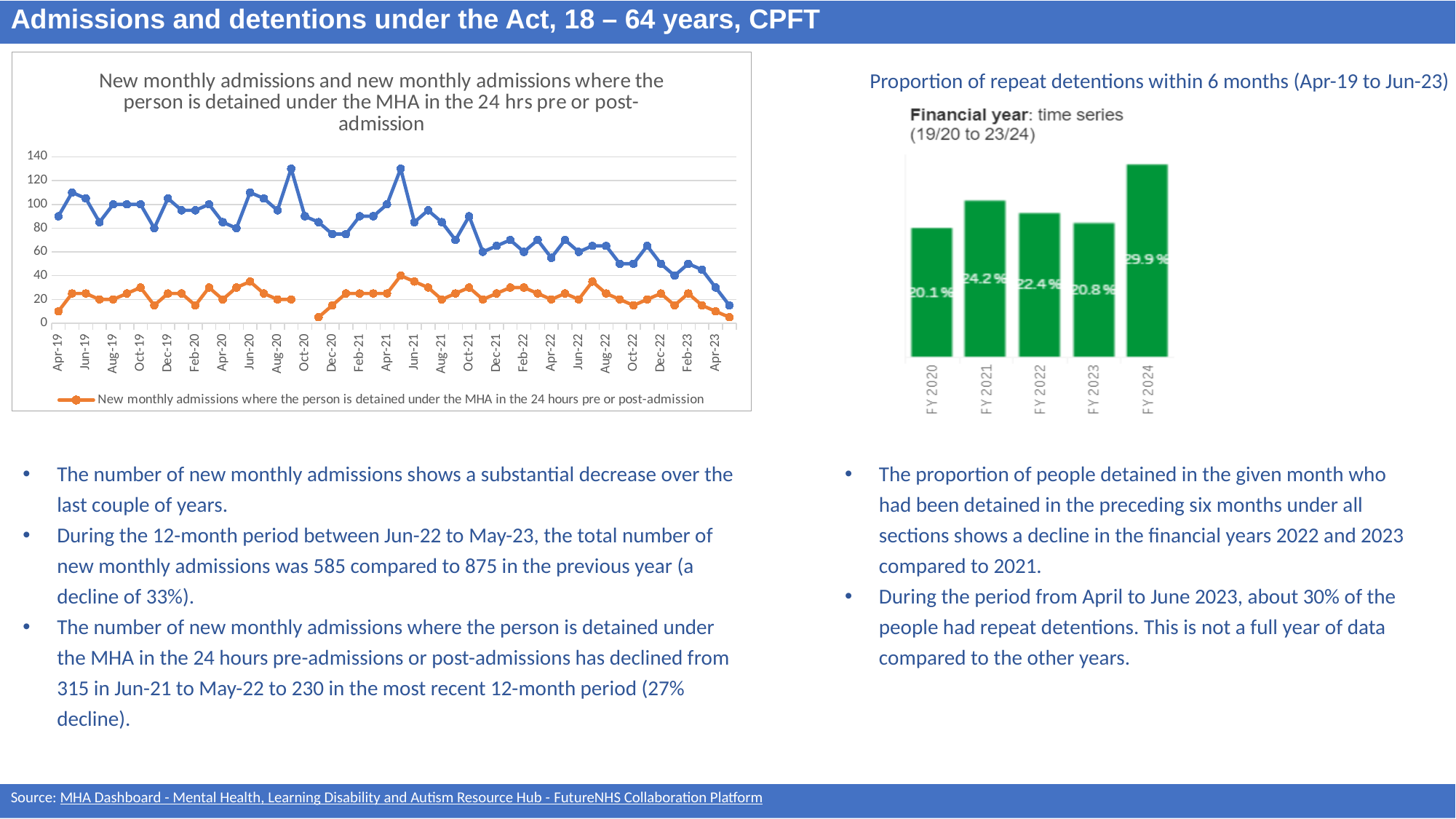
In the 'Proportion of repeat detentions within 6 months' chart, what is the value for FY 2021? 24.2% In the 'Proportion of repeat detentions within 6 months' chart, which is larger, the value for FY 2022 or FY 2023? FY 2022 How many lines are plotted in the left chart showing new monthly admissions? 2 In the left chart, is the value of the blue line (new monthly admissions) for Apr-23 greater or less than 20? greater How many financial years are shown in the 'Proportion of repeat detentions within 6 months' chart? 5 In the 'Proportion of repeat detentions within 6 months' chart, what is the value for FY 2024? 29.9% In the 'Proportion of repeat detentions within 6 months' chart, what is the difference in percentage points between FY 2024 and FY 2020? 9.8 percentage points In the 'Proportion of repeat detentions within 6 months' chart, which financial year has the lowest proportion? FY 2020 In the left chart, does the blue line for new monthly admissions generally rise or fall from Apr-19 to Apr-23? Fall What kind of chart is the chart on the left of the slide showing new monthly admissions? Line chart In the 'Proportion of repeat detentions within 6 months' chart, which financial year has the highest proportion? FY 2024 What kind of chart is the 'Proportion of repeat detentions within 6 months' chart? Bar chart